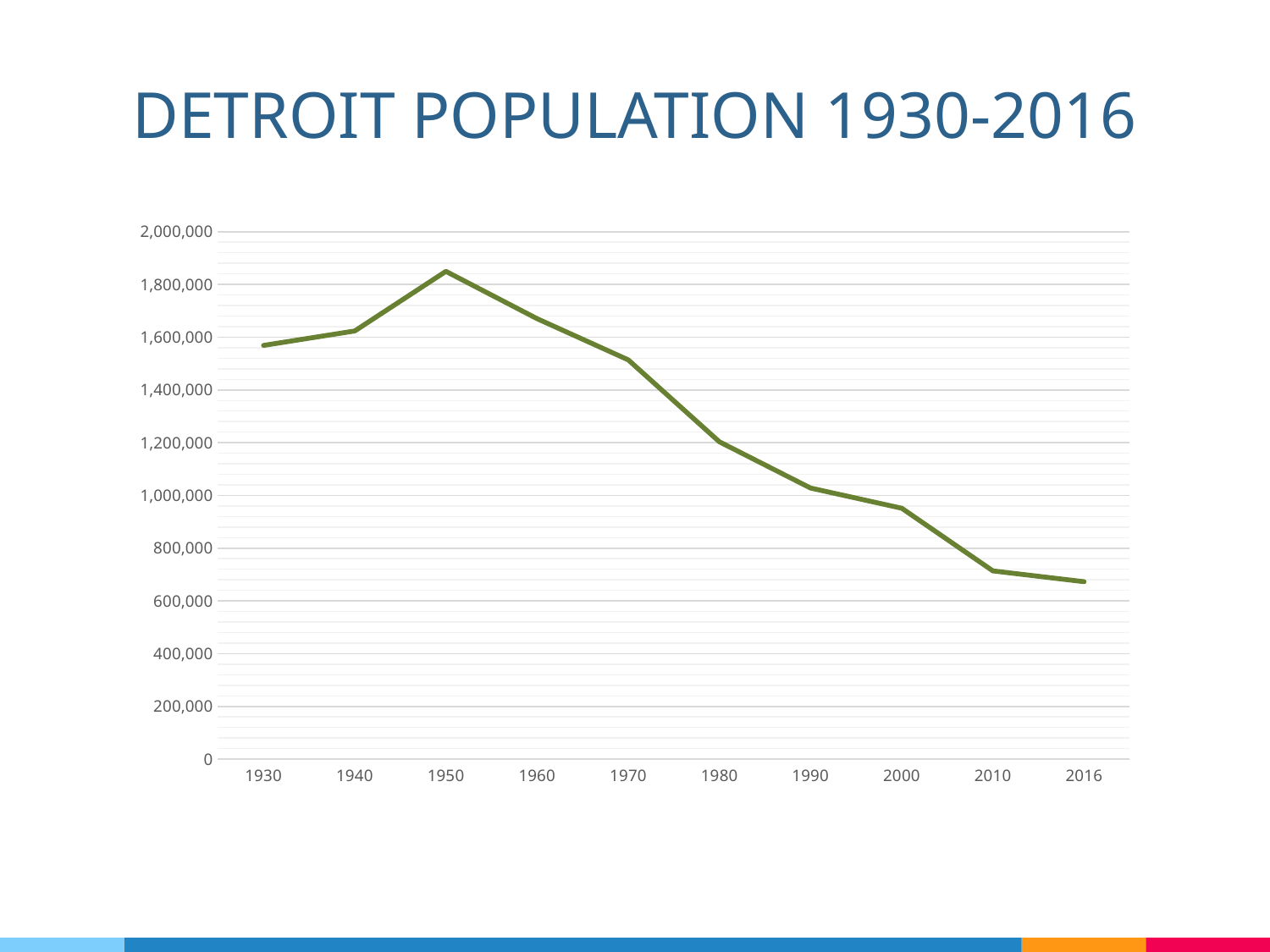
Is the population in 1980 greater or less than 1,400,000? less How many years are plotted along the x axis? 10 Is the population in 2010 greater or less than 800,000? less What is the title of the chart? DETROIT POPULATION 1930-2016 In which year does the population reach its highest value? 1950 Is the population in 1930 greater or less than 1,400,000? greater What kind of chart is shown on the slide? line chart In which year is the population at its lowest value? 2016 Does the population rise or fall from 1950 to 2016? fall Which year has the larger population, 1970 or 1990? 1970 Which year has the larger population, 1940 or 2000? 1940